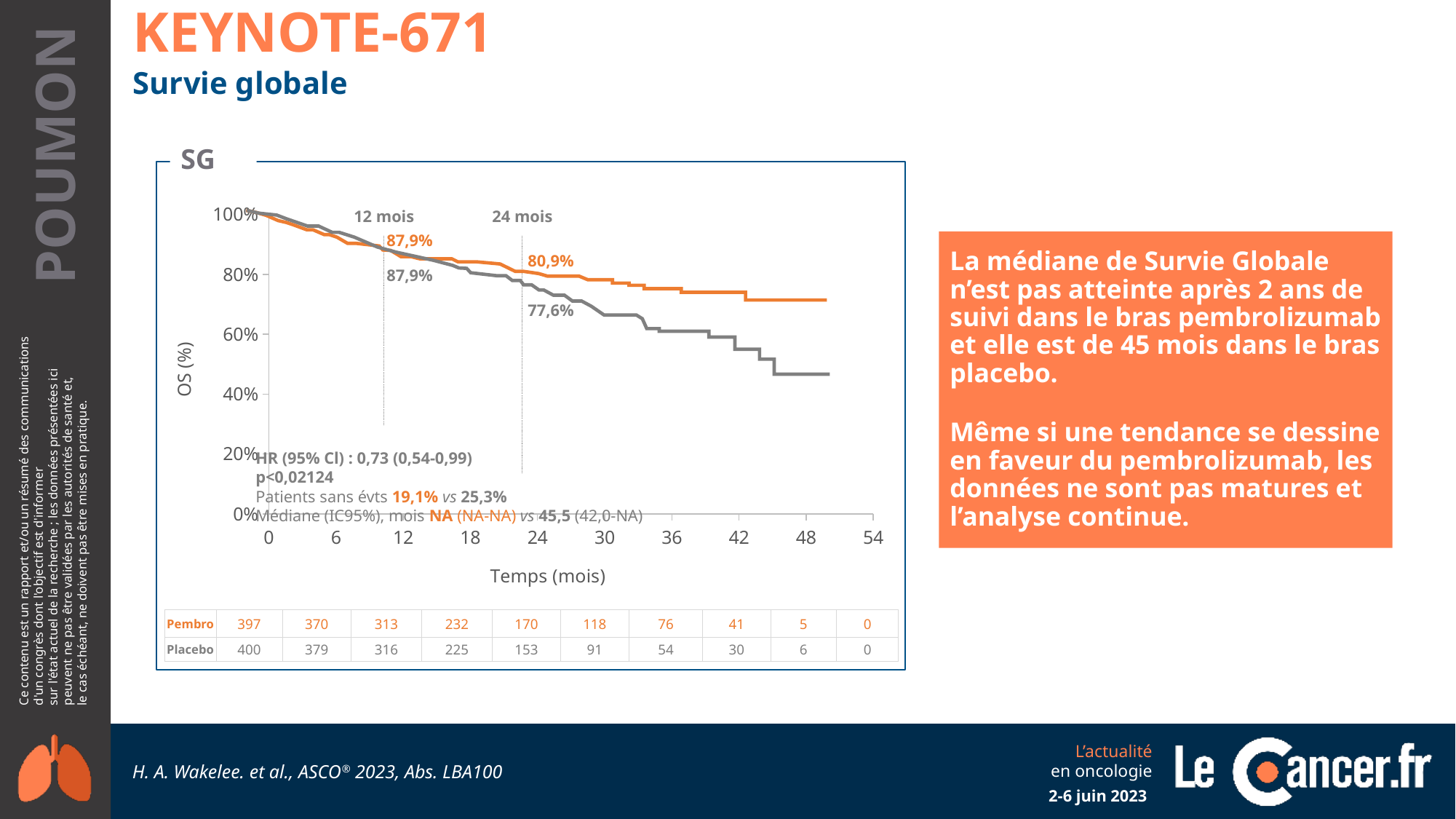
What is the overall survival rate at 24 months for the Placebo arm? 77,6% What is the overall survival rate at 12 months for the Pembro arm? 87,9% At 24 months, which arm has the higher overall survival rate, Pembro or Placebo? Pembro How many treatment arms are plotted on the survival chart? 2 Is the Pembro curve at 48 months greater or less than 60%? greater Do the survival curves rise or fall as time increases along the x axis? fall What is the overall survival rate at 24 months for the Pembro arm? 80,9% What is the label of the x axis of the survival chart? Temps (mois) What is the difference in overall survival at 24 months between the Pembro and Placebo arms? 3,3 points How many patients were at risk in the Pembro arm at 24 months? 170 What kind of chart is shown in the SG panel? line chart How many patients were at risk in the Placebo arm at 0 months? 400